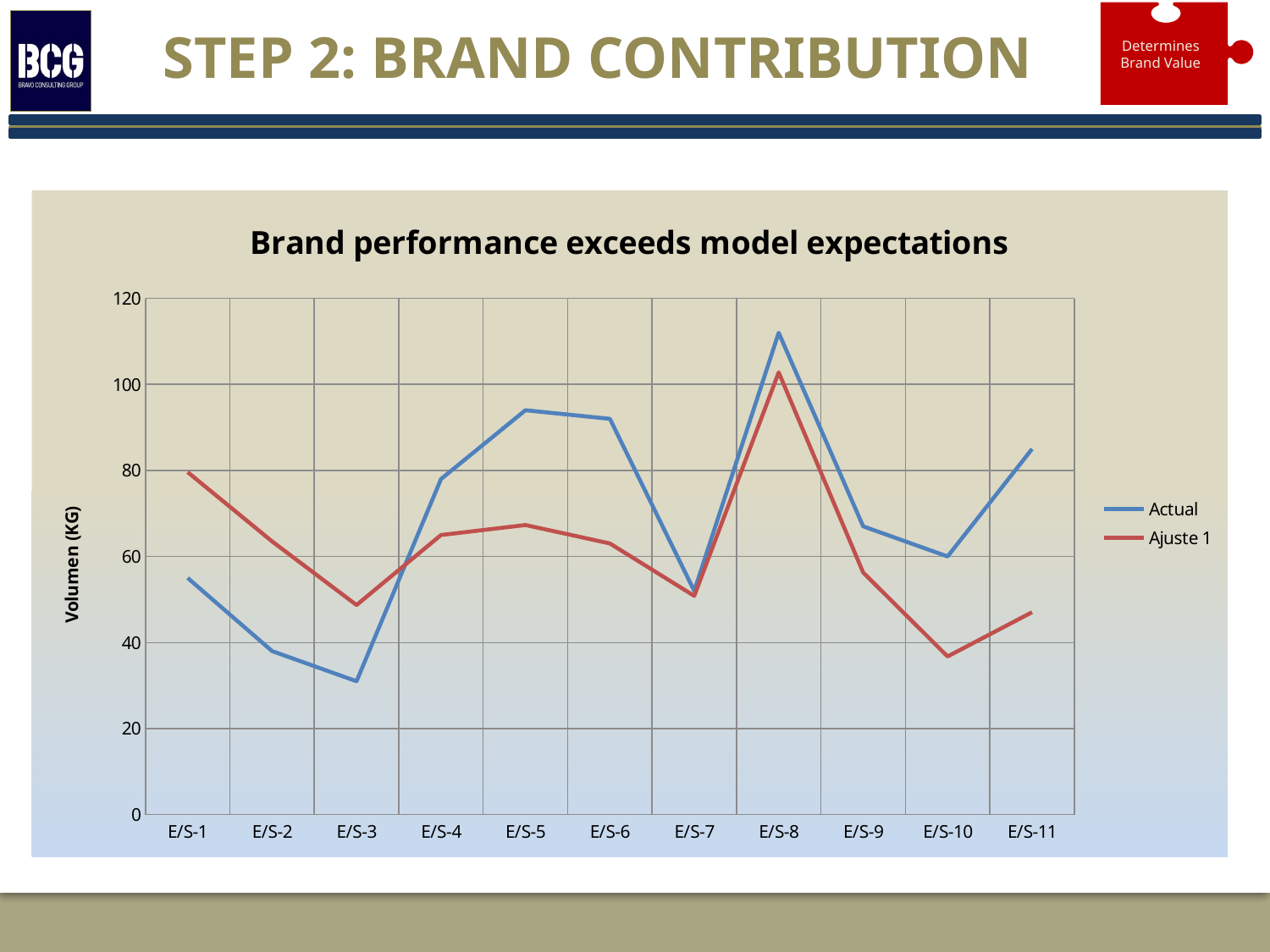
At which category does the Ajuste 1 series reach its highest value? E/S-8 Is the Actual value for E/S-8 greater or less than 100? greater What is the title of the chart? Brand performance exceeds model expectations At E/S-1, which series has the higher value, Actual or Ajuste 1? Ajuste 1 What kind of chart is shown on the slide? line chart At E/S-5, which series has the higher value, Actual or Ajuste 1? Actual Is the Actual value for E/S-3 greater or less than 40? less At which category does the Ajuste 1 series reach its lowest value? E/S-10 How many categories are shown on the x axis? 11 At which category does the Actual series reach its lowest value? E/S-3 At which category does the Actual series reach its highest value? E/S-8 How many series does the legend list? 2